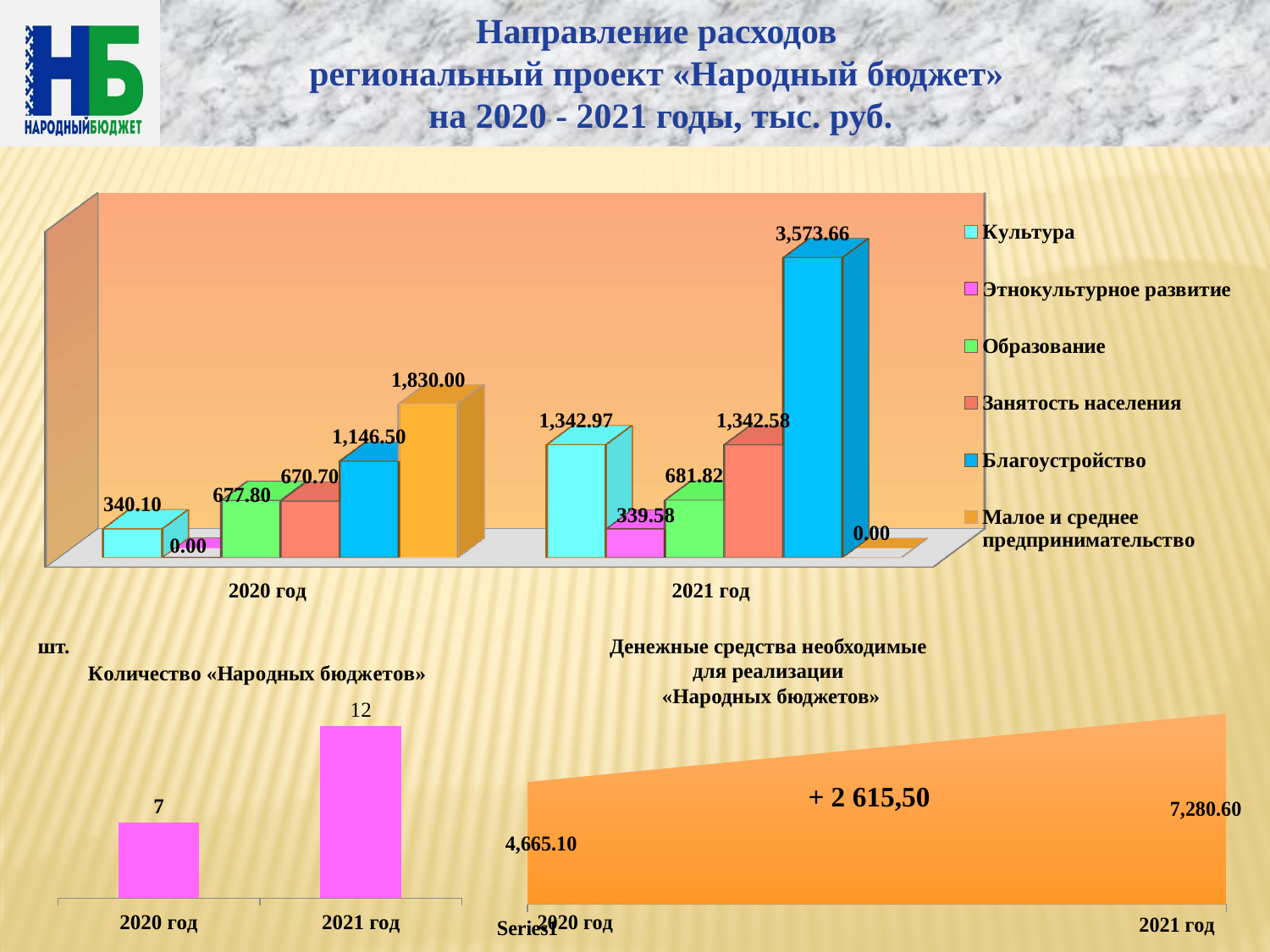
In the top chart (Направление расходов), what is the value for Малое и среднее предпринимательство in 2020 год? 1,830.00 How many series does the legend of the top chart (Направление расходов) list? 6 In the top chart (Направление расходов), what is the value for Культура in 2021 год? 1,342.97 In the top chart (Направление расходов), which is larger in 2020 год: Образование or Занятость населения? Образование In the top chart (Направление расходов), which category has the highest value in 2020 год? Малое и среднее предпринимательство In the top chart (Направление расходов), what is the value for Благоустройство in 2021 год? 3,573.66 In the bottom-right chart (Денежные средства необходимые для реализации «Народных бюджетов»), what is the value for 2020 год? 4,665.10 In the bottom-right chart (Денежные средства необходимые для реализации «Народных бюджетов»), do the values rise or fall from 2020 год to 2021 год? rise In the bottom-left chart (Количество «Народных бюджетов»), what is the value for 2021 год? 12 In the top chart (Направление расходов), which category has the lowest value in 2021 год? Малое и среднее предпринимательство In the top chart (Направление расходов), what is the difference between the Культура values for 2021 год and 2020 год? 1,002.87 In the bottom-left chart (Количество «Народных бюджетов»), what is the difference between 2021 год and 2020 год? 5